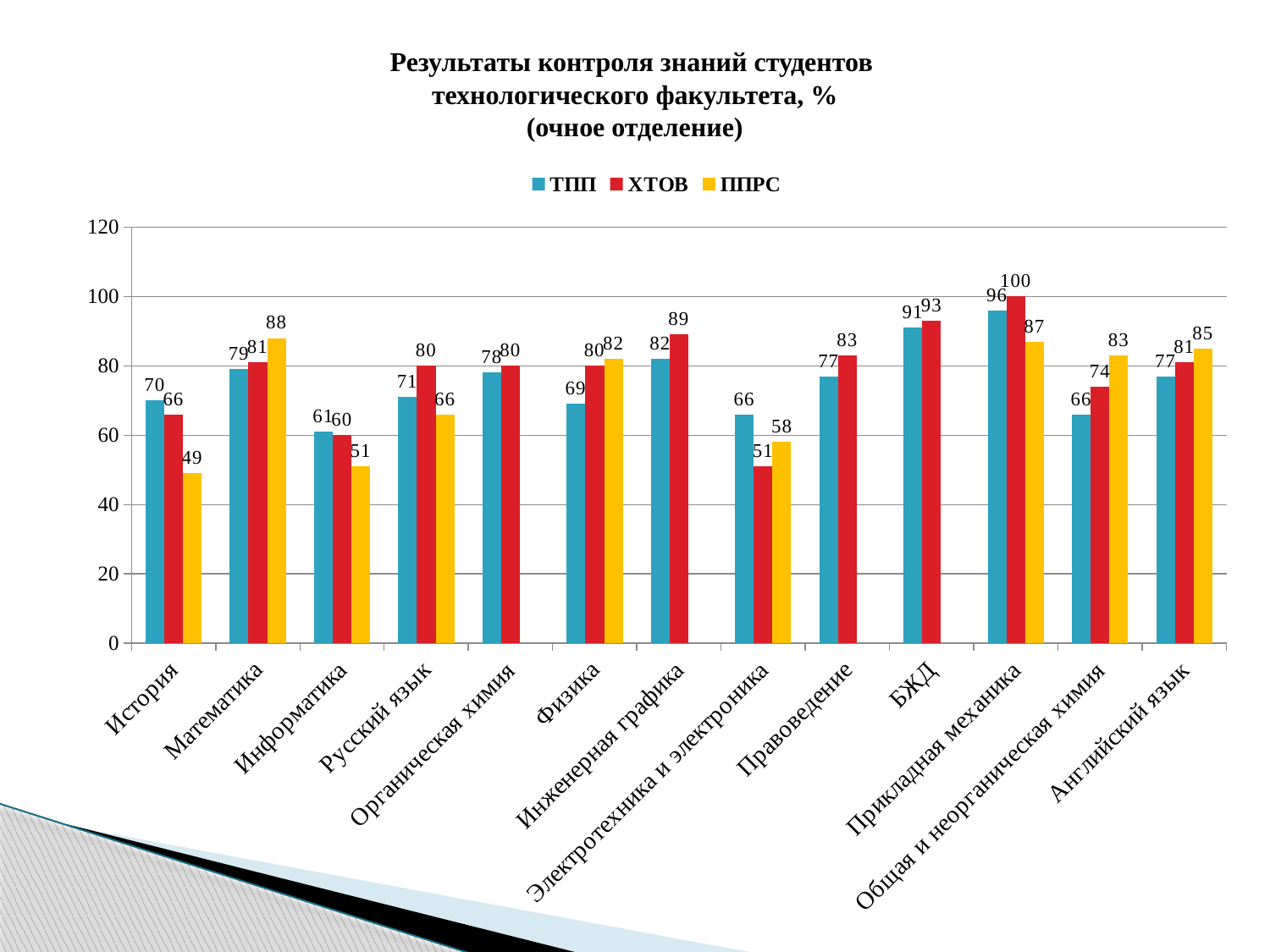
What is the difference between the ППРС and ТПП values for Общая и неорганическая химия? 17 How many series does the legend list? 3 How many categories are shown on the x axis? 13 Which series is shown in yellow in the legend? ППРС What is the ППРС value for Математика? 88 What is the ХТОВ value for Электротехника и электроника? 51 Which is larger for Русский язык: the ХТОВ value or the ППРС value? ХТОВ What kind of chart is shown on the slide? Bar chart Which category has the lowest ТПП value? Информатика What is the ТПП value for История? 70 Which category has the highest ХТОВ value? Прикладная механика Which category has the lowest ППРС value? История